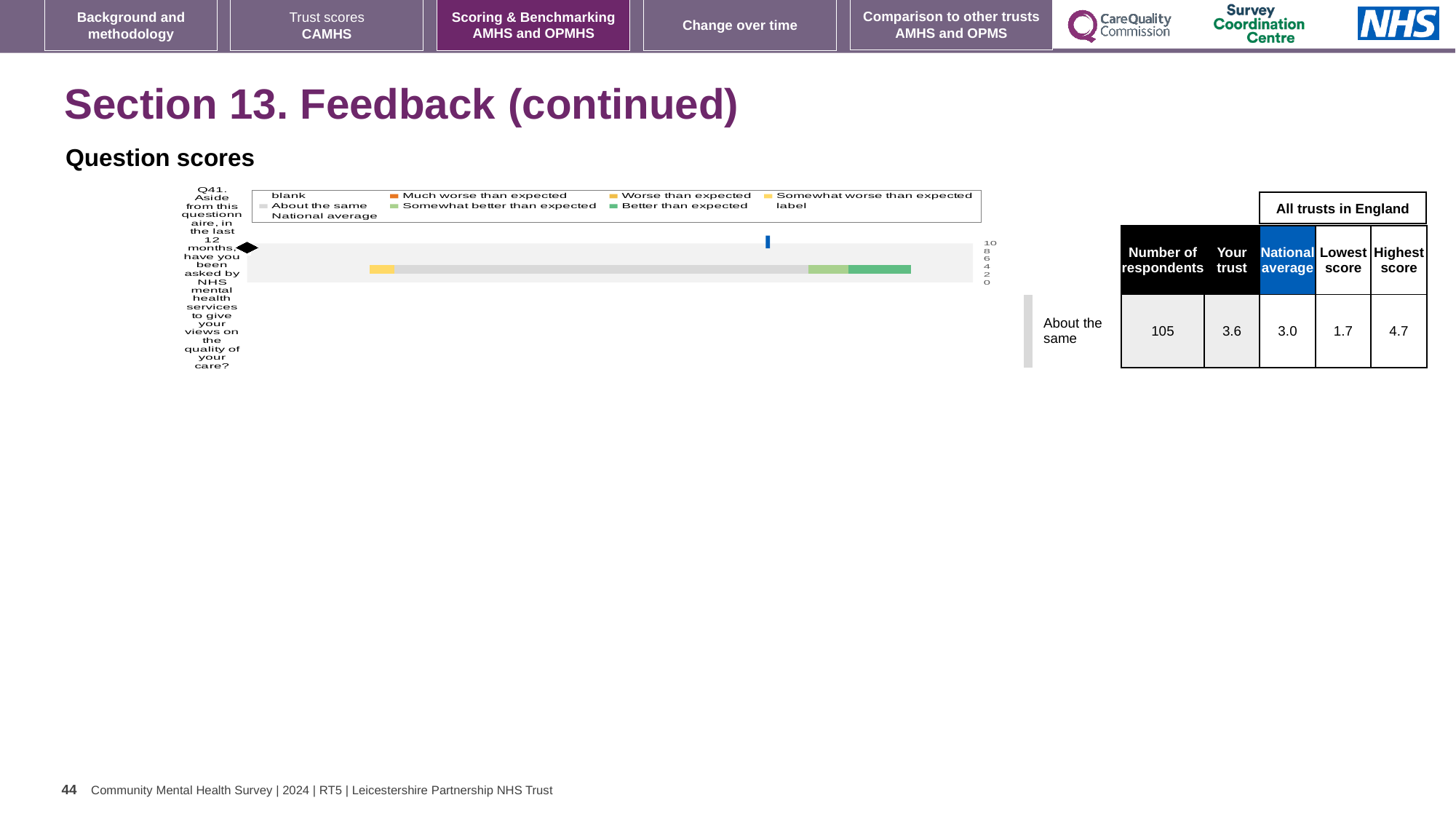
According to the table beside the chart, what is the highest score among all trusts in England for Q41? 4.7 According to the table beside the chart, what is the national average score for Q41? 3.0 What is the difference between the highest score and the lowest score for Q41 in the table beside the chart? 3.0 How many survey questions are plotted in the chart? 1 For Q41, which is larger: the 'Your trust' score or the national average? Your trust According to the table beside the chart, what is the 'Your trust' score for Q41? 3.6 Which question number is plotted in the chart? Q41 What kind of chart is shown on the slide for Q41? bar chart According to the table beside the chart, how many respondents answered Q41? 105 What benchmark category is shown next to the chart for Q41? About the same What colour does the legend use for 'Better than expected'? green According to the table beside the chart, what is the lowest score among all trusts in England for Q41? 1.7